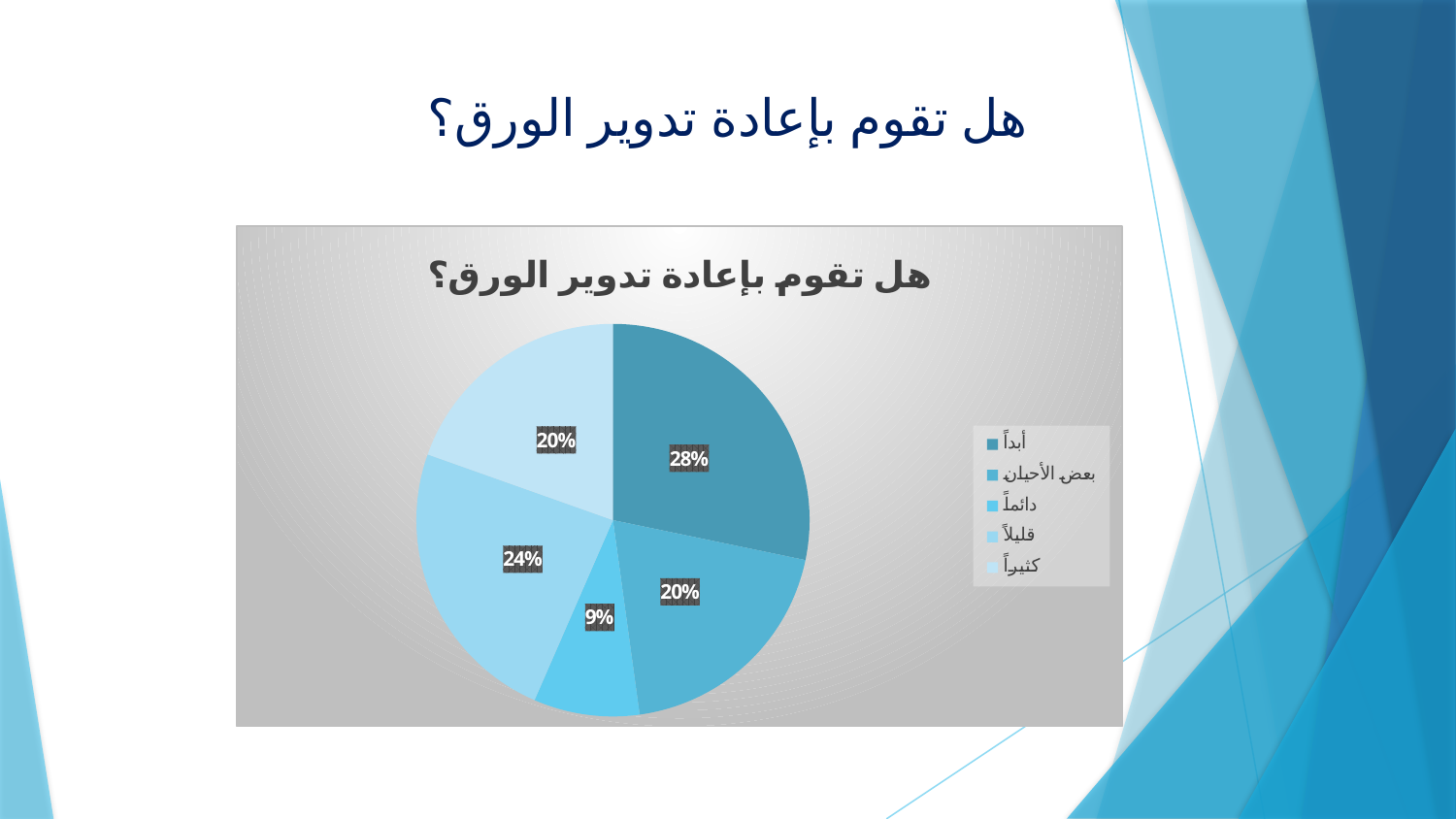
What type of chart is shown on the slide? pie chart Which slice is larger, قليلاً or كثيراً? قليلاً What percentage of the pie is the slice for بعض الأحيان? 20% What is the difference in percentage points between the أبداً slice and the دائماً slice? 19 How many categories does the legend list? 5 What percentage of the pie is the slice for دائماً? 9% Which category has the smallest slice of the pie? دائماً Which two categories share the same percentage of 20%? بعض الأحيان and كثيراً What is the title of the chart? هل تقوم بإعادة تدوير الورق؟ What percentage of the pie is the slice for أبداً? 28% Which category has the largest slice of the pie? أبداً What percentage of the pie is the slice for قليلاً? 24%